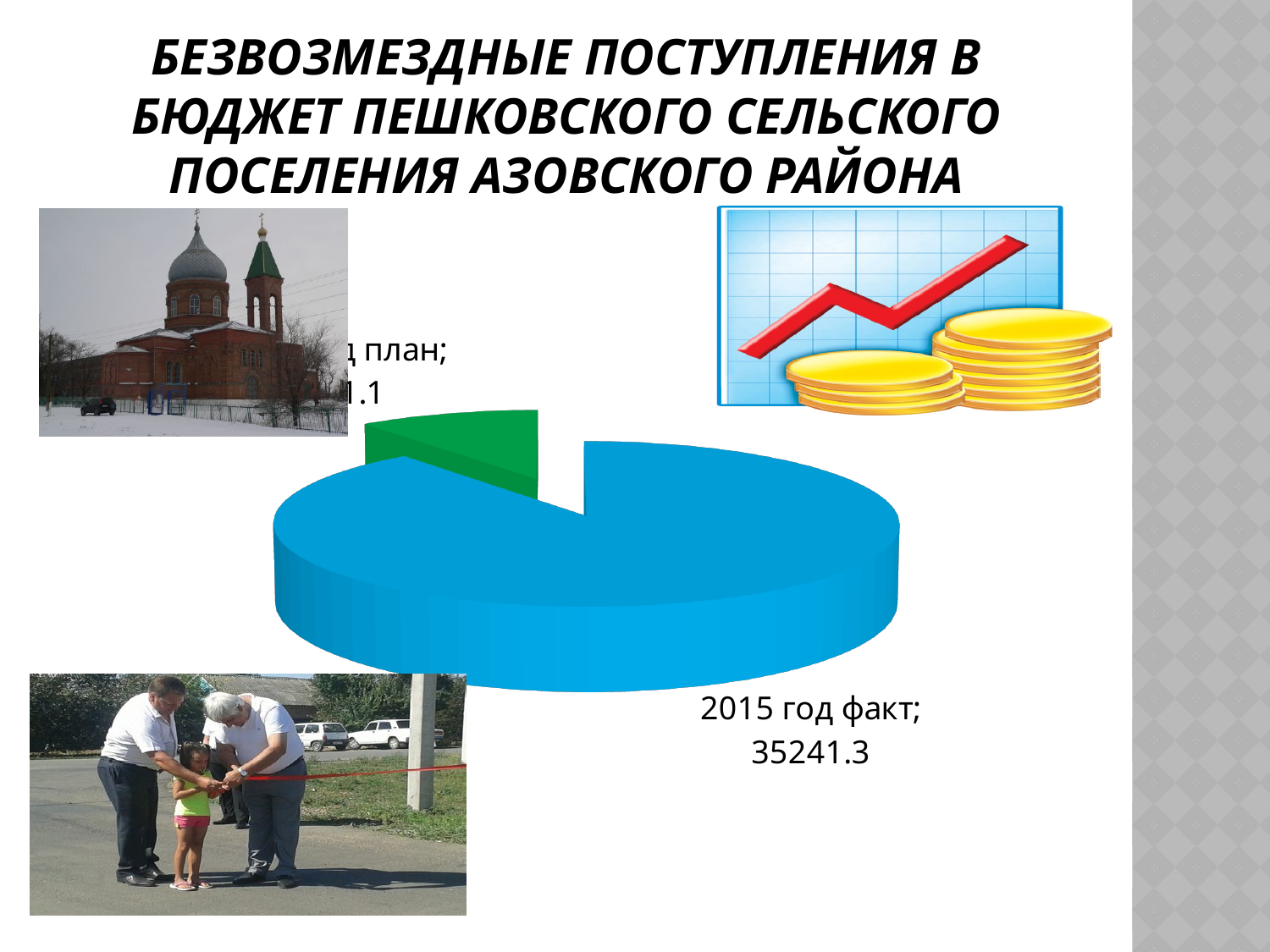
What is the title of the slide containing the pie chart? Безвозмездные поступления в бюджет Пешковского сельского поселения Азовского района What colour is the slice labelled "2015 год факт"? blue Which slice is larger: the blue slice labelled "2015 год факт" or the green slice? 2015 год факт How many slices does the pie chart have? 2 What value is shown for the slice labelled "2015 год факт"? 35241.3 What kind of chart is shown on the slide? pie chart Which slice of the pie chart is the largest? 2015 год факт